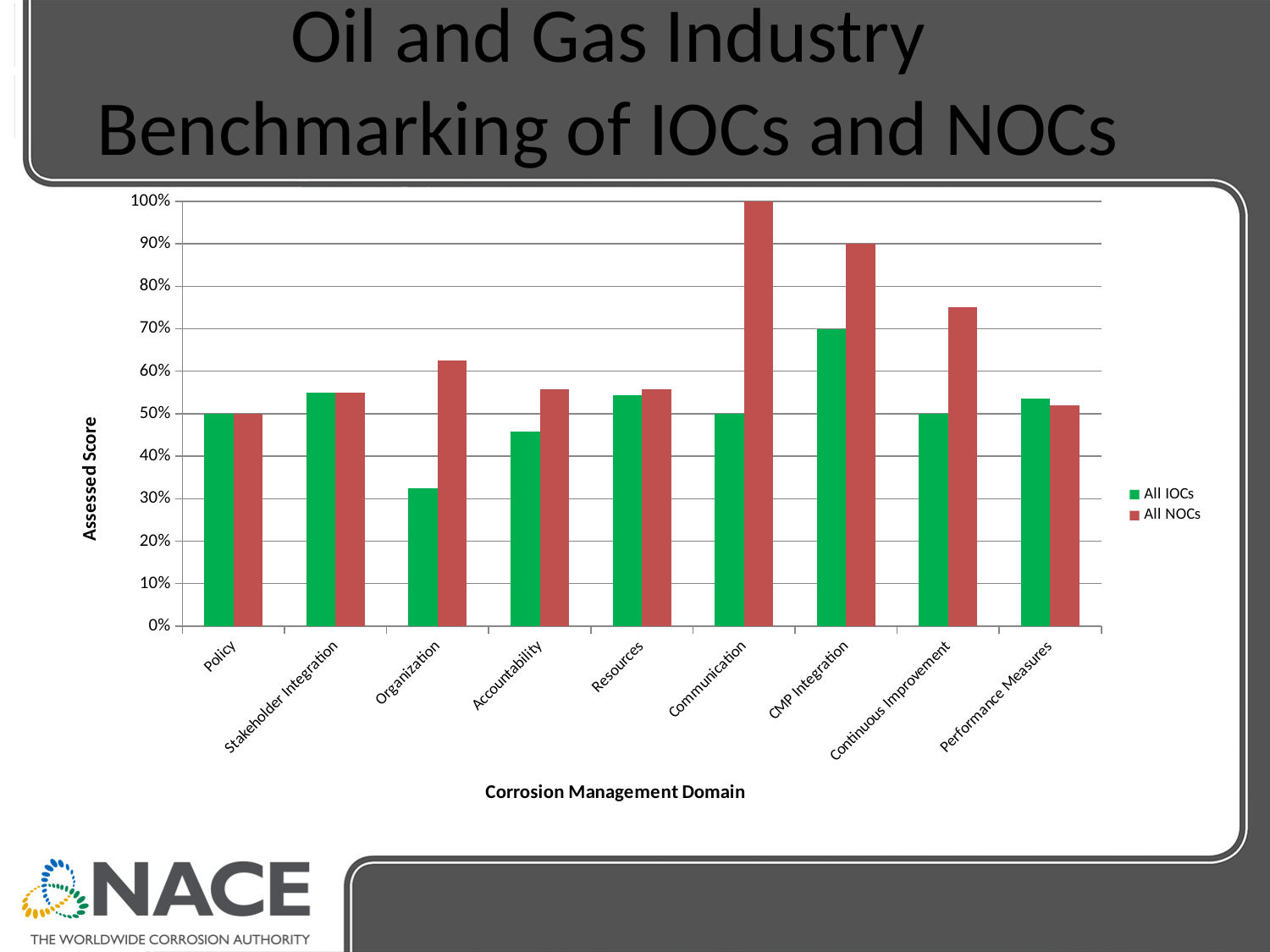
In the Organization domain, which series has the larger assessed score, All IOCs or All NOCs? All NOCs In the Communication domain, what is the difference between the All NOCs score and the All IOCs score? 50% What kind of chart is shown on the slide? bar chart Which domain has the lowest assessed score for All IOCs? Organization What is the assessed score for All IOCs in the Policy domain? 50% How many corrosion management domains are shown on the x axis? 9 What is the assessed score for All NOCs in the CMP Integration domain? 90% Which domain has the highest assessed score for All NOCs? Communication Is the All NOCs value for Continuous Improvement greater or less than 70%? greater How many series does the legend list? 2 Is the All IOCs value for Organization greater or less than 40%? less What is the assessed score for All NOCs in the Communication domain? 100%